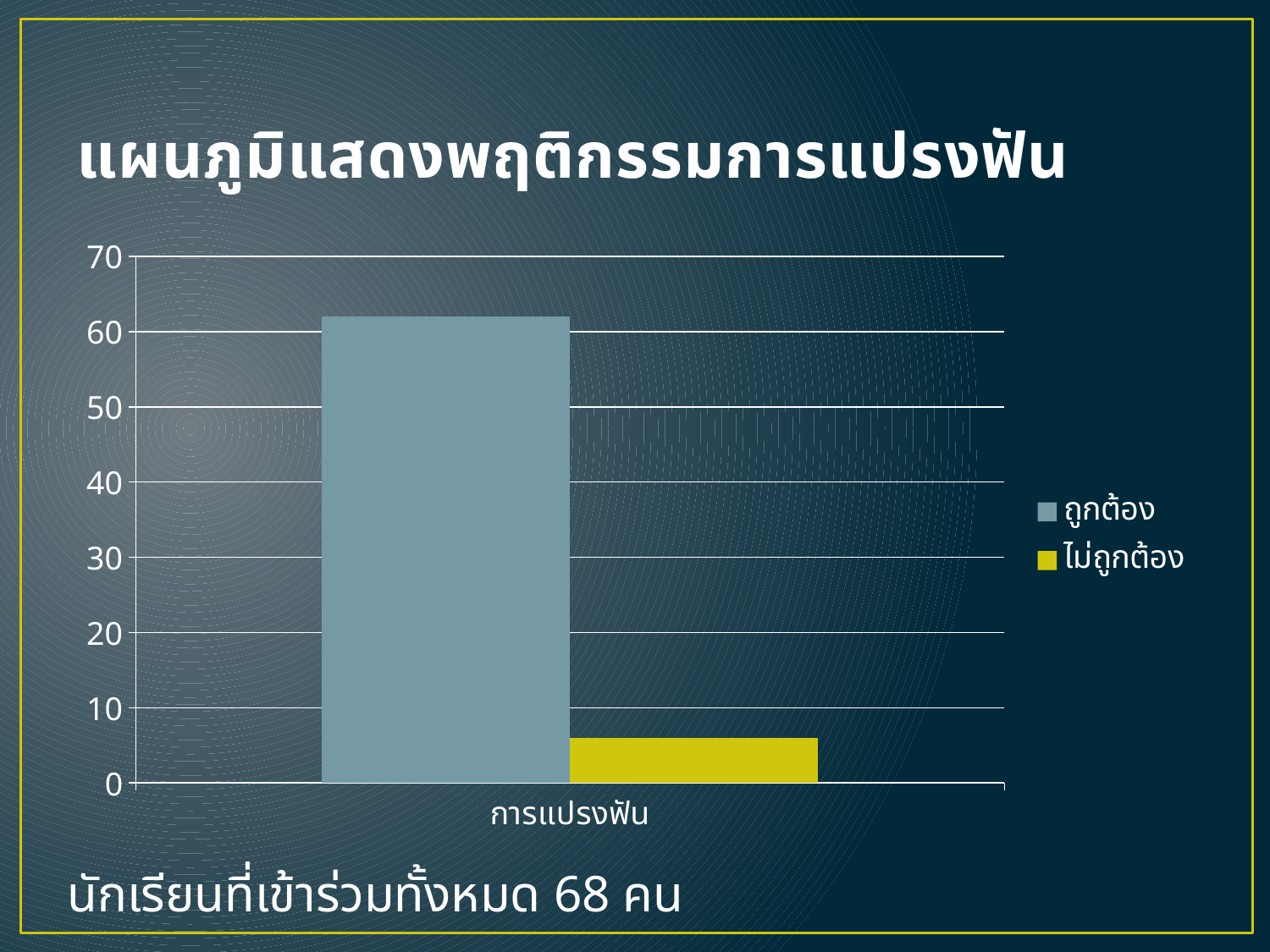
Is the value for ไม่ถูกต้อง greater or less than 10? less Which is larger for การแปรงฟัน, ถูกต้อง or ไม่ถูกต้อง? ถูกต้อง How many categories are shown on the x axis? 1 Which series has the highest value for การแปรงฟัน? ถูกต้อง Which series is shown in yellow? ไม่ถูกต้อง Is the value for ถูกต้อง greater or less than 50? greater What is the title of the chart? แผนภูมิแสดงพฤติกรรมการแปรงฟัน Which series has the lowest value for การแปรงฟัน? ไม่ถูกต้อง What is the label of the category on the x axis? การแปรงฟัน How many series does the legend list? 2 What kind of chart is shown on the slide? bar chart Is the value for ถูกต้อง greater or less than 70? less